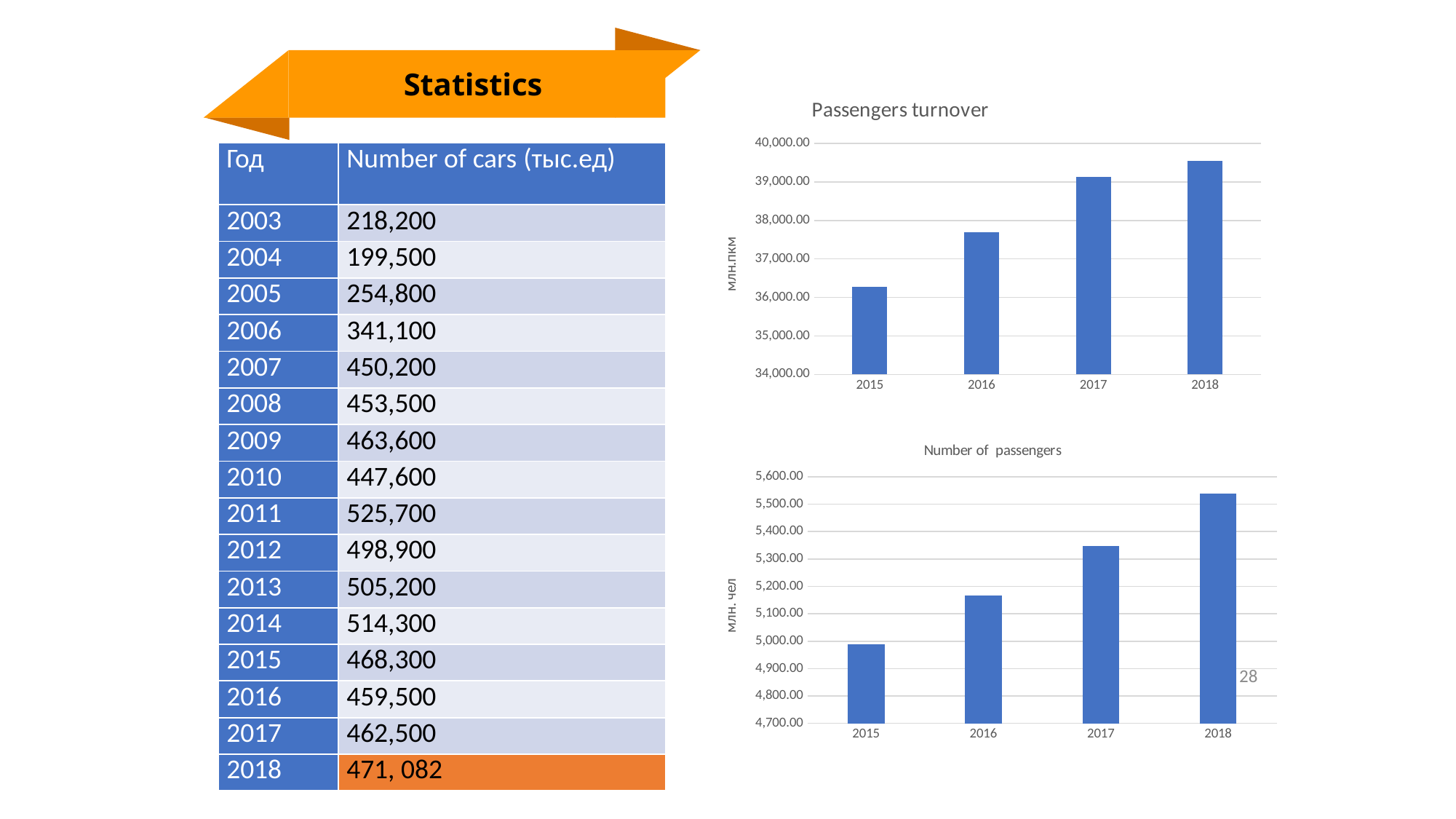
In the Passengers turnover chart, is the value for 2016 greater or less than 38,000.00? less In the Number of passengers chart, is the value for 2018 greater or less than 5,500.00? greater In the Passengers turnover chart, which year has the lowest value? 2015 In the Passengers turnover chart, is the value for 2017 greater or less than 38,000.00? greater What kind of chart is the Number of passengers chart? bar chart In the Passengers turnover chart, do the values rise or fall from 2015 to 2018? rise In the Passengers turnover chart, which year has the highest value? 2018 In the Number of passengers chart, which year has the lowest value? 2015 In the Number of passengers chart, how many years are shown on the x axis? 4 In the Number of passengers chart, which year has the highest value? 2018